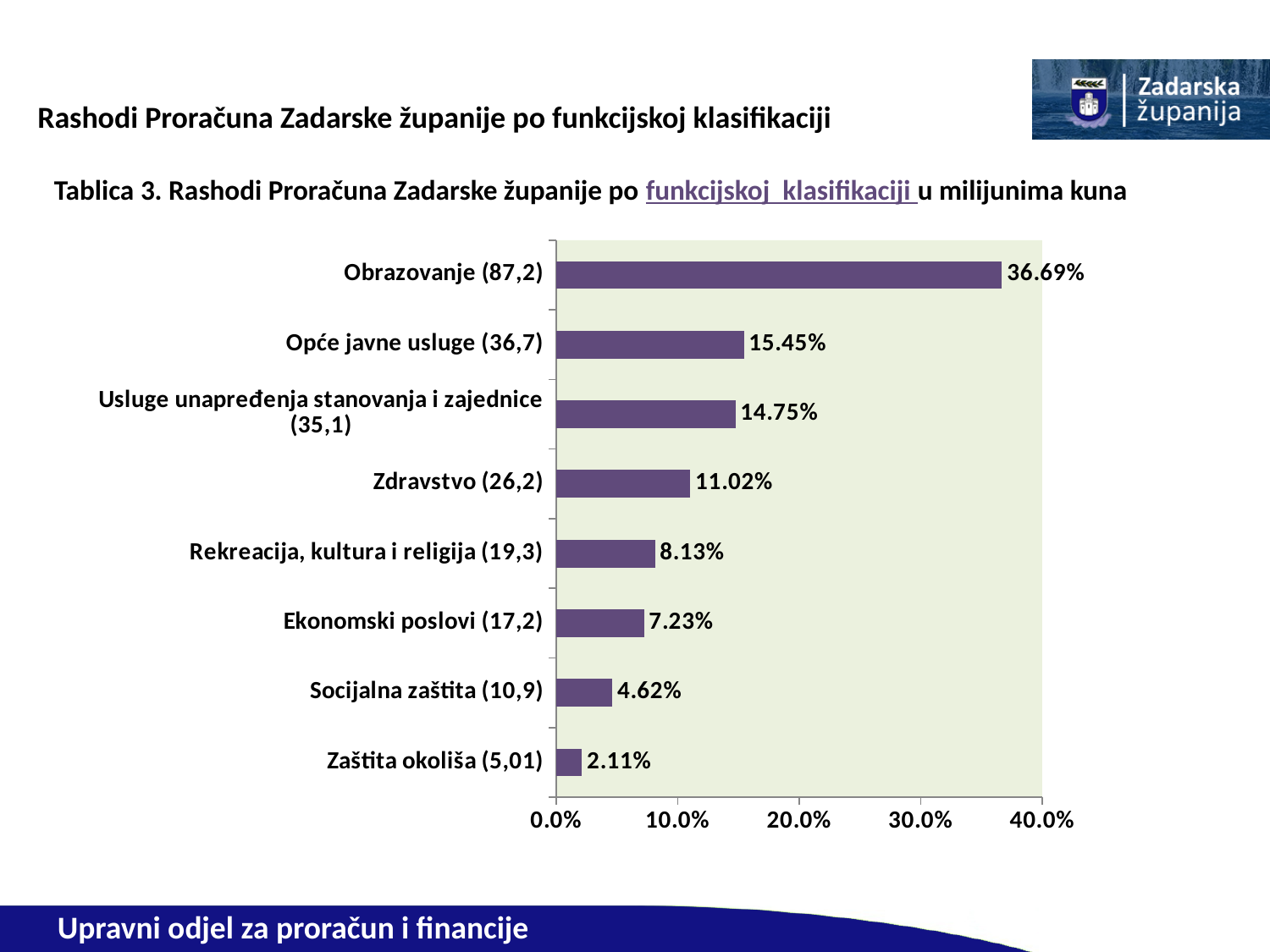
What is the highest value shown on the x axis of the chart? 40.0% Is the value for Zdravstvo (26,2) greater or less than 10.0%? greater Which category has the lowest percentage? Zaštita okoliša (5,01) Which is larger, the percentage for Opće javne usluge (36,7) or for Usluge unapređenja stanovanja i zajednice (35,1)? Opće javne usluge (36,7) How many categories are shown in the chart? 8 What percentage is labelled on the bar for Socijalna zaštita (10,9)? 4.62% Which category has the highest percentage? Obrazovanje (87,2) What percentage is shown for Obrazovanje (87,2)? 36.69% What is the value of the bar for Zdravstvo (26,2)? 11.02% What kind of chart is shown on the slide? Bar chart What is the difference between the percentages for Rekreacija, kultura i religija (19,3) and Ekonomski poslovi (17,2)? 0.90% What is the difference between the percentages for Obrazovanje (87,2) and Opće javne usluge (36,7)? 21.24%